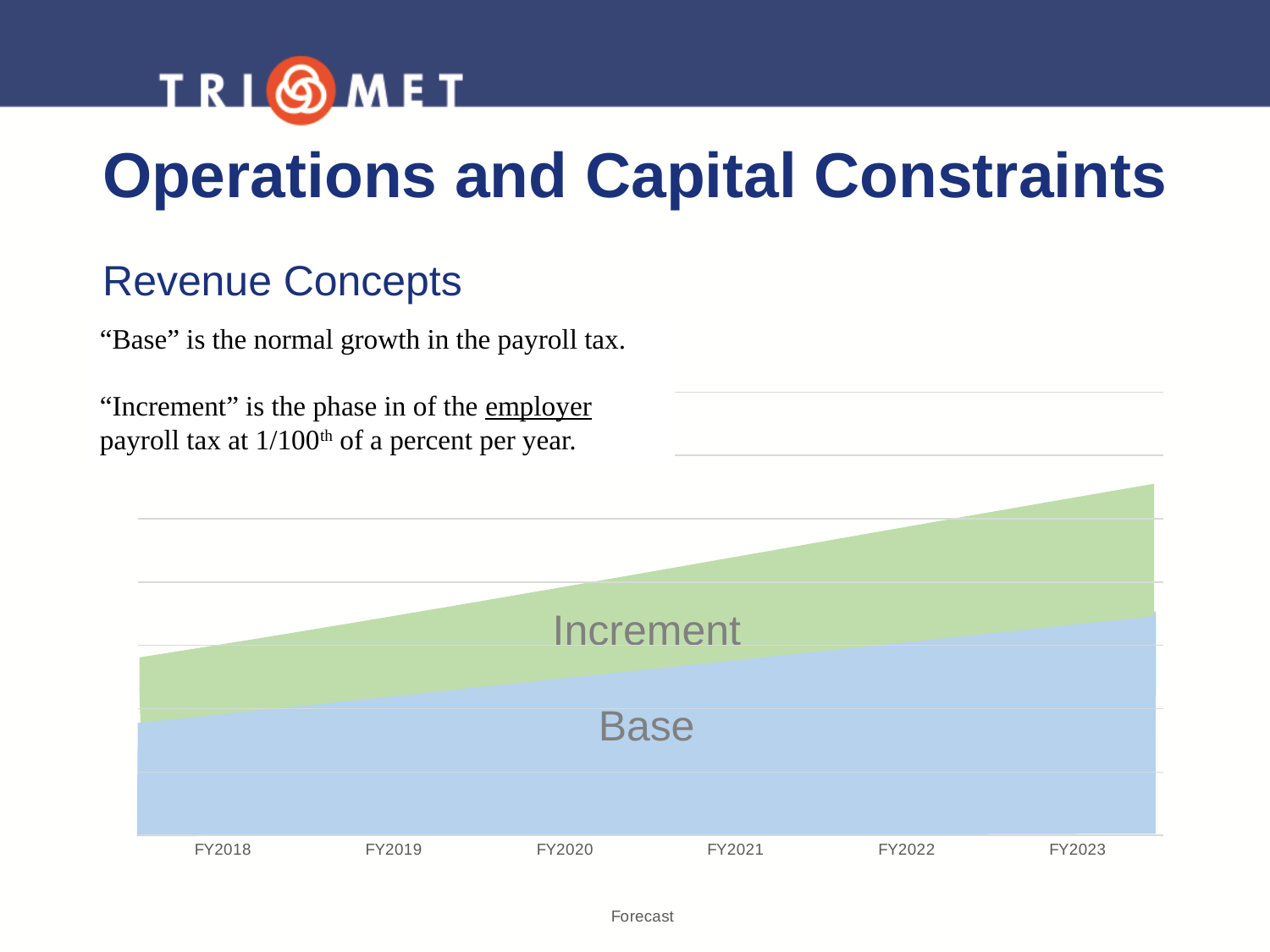
Which fiscal year is the first category on the x axis? FY2018 Which fiscal year is the last category on the x axis? FY2023 In FY2023, which series is larger, Base or Increment? Base Does the Base series rise or fall across the fiscal years shown? Rise Does the total of Base plus Increment rise or fall from FY2018 to FY2023? Rise What are the names of the two series plotted in the chart? Base and Increment What kind of chart is shown on the slide? Area chart What is the label shown beneath the x axis of the chart? Forecast How many fiscal years are shown along the x axis of the chart? 6 How many series are plotted in the chart? 2